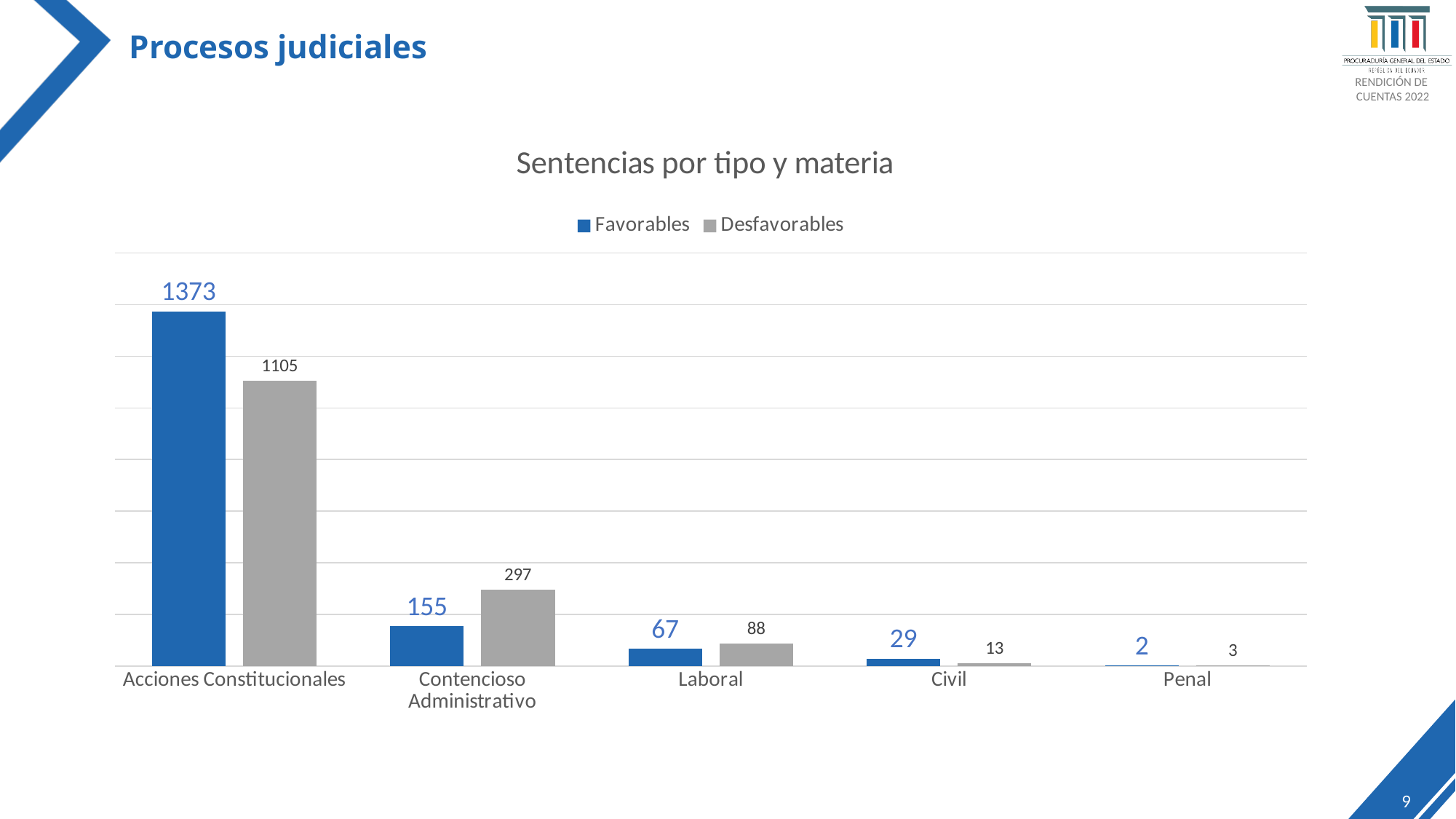
How many categories are shown on the x axis? 5 What is the Desfavorables value for Penal? 3 What is the Favorables value for Laboral? 67 How many series does the legend list? 2 Which is larger for Contencioso Administrativo, Favorables or Desfavorables? Desfavorables Which category has the highest Favorables value? Acciones Constitucionales Which category has the lowest Desfavorables value? Penal What kind of chart is shown on the slide? Bar chart What is the difference between the Favorables and Desfavorables values for Acciones Constitucionales? 268 What is the Favorables value for Acciones Constitucionales? 1373 What is the title of the chart? Sentencias por tipo y materia What is the Desfavorables value for Contencioso Administrativo? 297